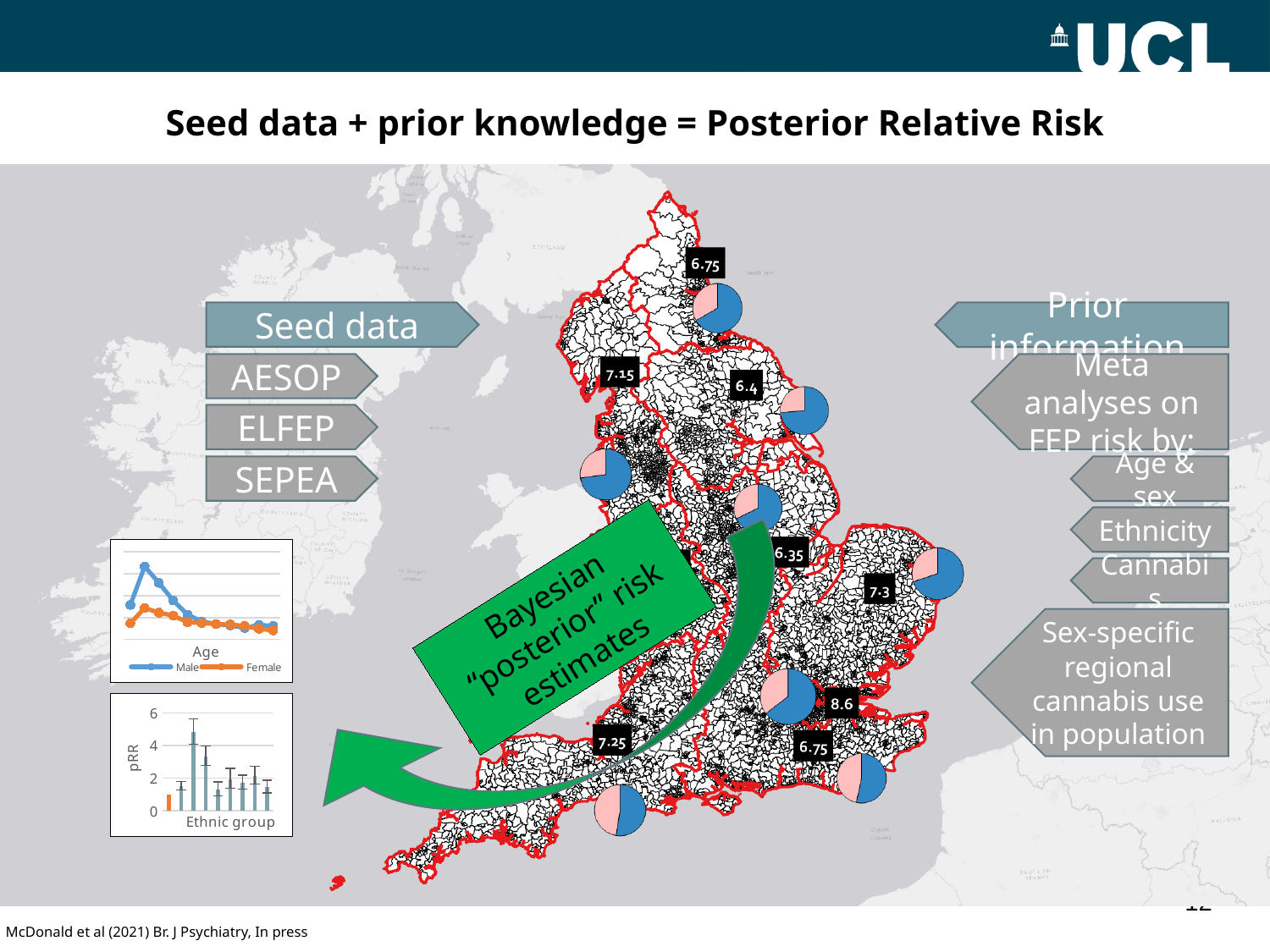
In the bottom-left Ethnic group chart, which bar from the left is the tallest? the third bar In the bottom-left Ethnic group chart, is the tallest bar greater or less than 4? greater What kind of chart is the upper-left chart with the Age axis? line chart What are the two legend entries in the upper-left Age chart? Male and Female In the bottom-left Ethnic group chart, is the tallest bar greater or less than 6? less How many series does the legend of the upper-left Age chart list? 2 How many bars are plotted in the bottom-left Ethnic group chart? 9 What kind of chart is the bottom-left chart with the pRR axis? bar chart What is the y-axis label of the bottom-left Ethnic group chart? pRR In the upper-left Age chart, which series reaches the higher peak, Male or Female? Male In the bottom-left Ethnic group chart, is the first (orange) bar greater or less than 2? less In the upper-left Age chart, does the Male series rise or fall after its peak as age increases? fall